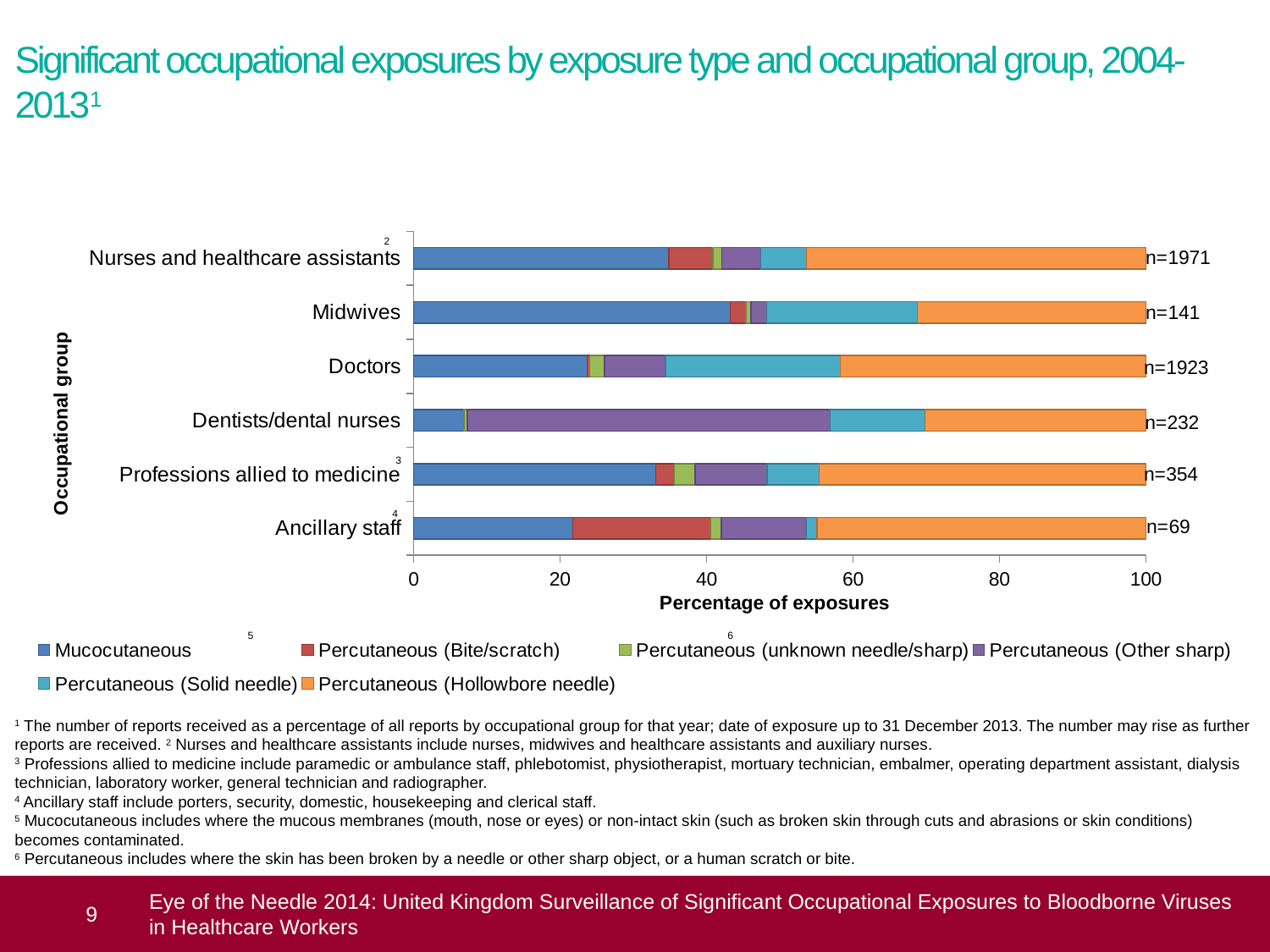
What is the title of the x axis? Percentage of exposures What is the n value shown for Doctors? n=1923 Which has a larger Mucocutaneous percentage, Nurses and healthcare assistants or Doctors? Nurses and healthcare assistants What is the n value shown for Midwives? n=141 What is the n value shown for Ancillary staff? n=69 How many exposure-type series does the legend list? 6 Which occupational group has the largest Percutaneous (Other sharp) percentage? Dentists/dental nurses What kind of chart is shown on the slide? Stacked horizontal bar chart Is the Mucocutaneous percentage for Dentists/dental nurses greater or less than 20? less Is the Mucocutaneous percentage for Midwives greater or less than 20? greater Which occupational group has the largest n value? Nurses and healthcare assistants How many occupational groups are plotted on the chart? 6